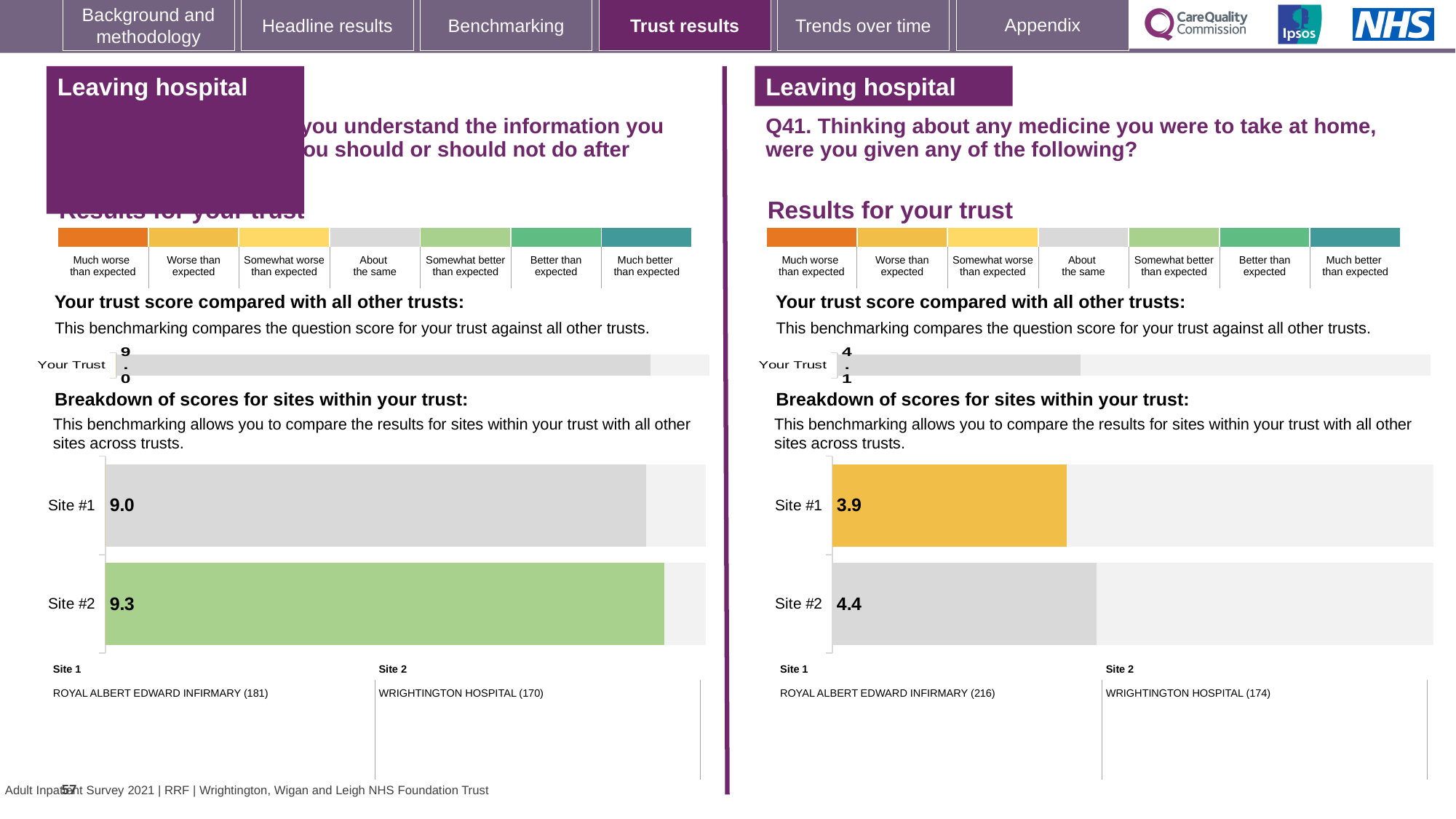
On the right-hand chart (Q41), what is the score for Site #2? 4.4 On the right-hand chart (Q41), which site has the lower score? Site #1 On the right-hand chart (Q41), what is the 'Your Trust' score? 4.1 On the left-hand chart, what is the difference between the Site #2 and Site #1 scores? 0.3 On the right-hand chart (Q41), what is the score for Site #1? 3.9 How many sites are shown in the site breakdown chart on the right-hand side (Q41)? 2 On the left-hand chart, which site has the higher score? Site #2 What type of chart is used for the breakdown of scores for sites on the left-hand side? Bar chart On the left-hand chart, what is the score for Site #2? 9.3 On the left-hand chart, what is the score for Site #1? 9.0 On the left-hand chart, what is the 'Your Trust' score? 9.0 On the right-hand chart (Q41), what is the difference between the Site #2 and Site #1 scores? 0.5